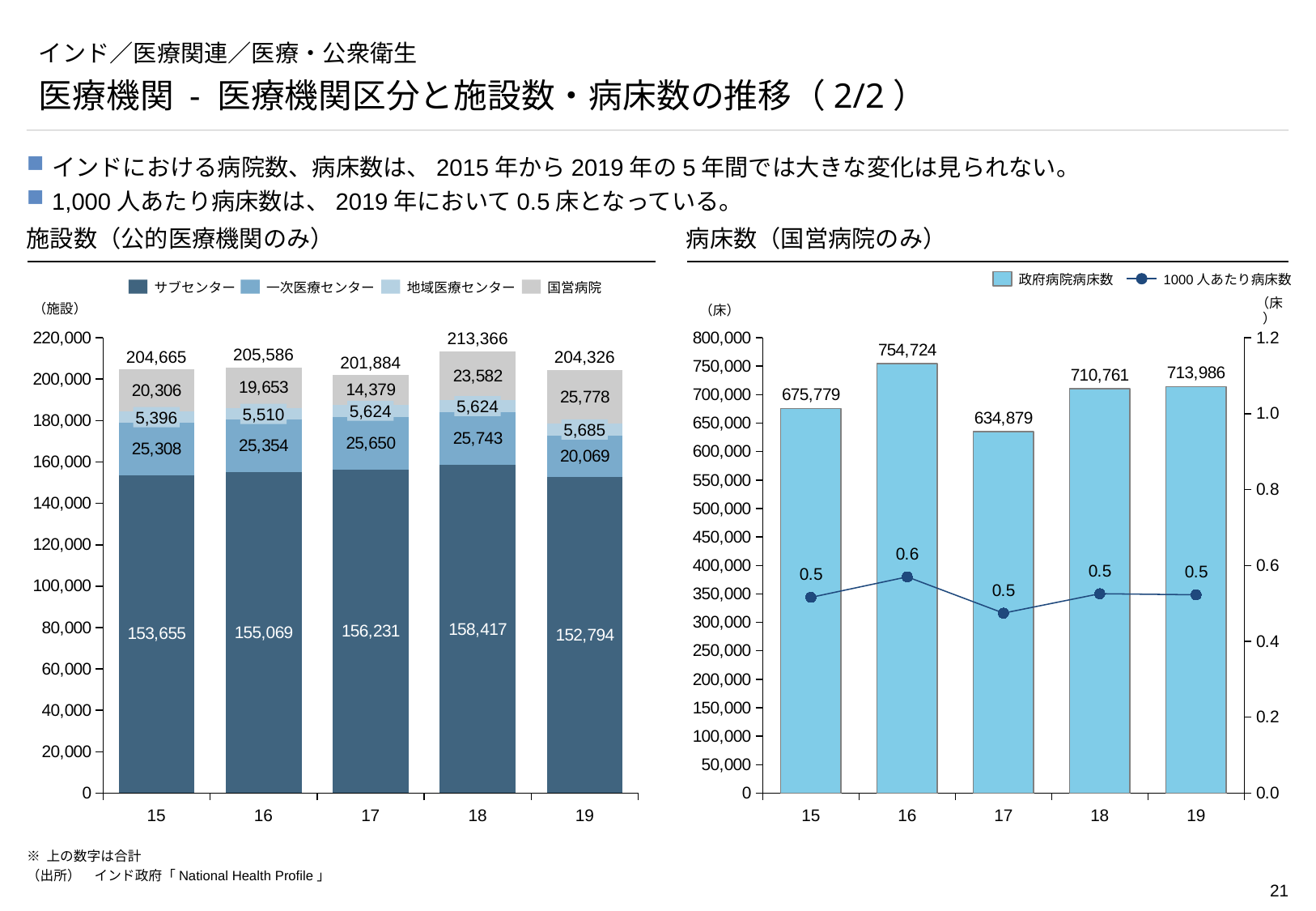
In the 施設数（公的医療機関のみ） chart, what is the total number of facilities shown above the bar for 18? 213,366 In the 病床数（国営病院のみ） chart, which year has the lowest value for 政府病院病床数? 17 In the 病床数（国営病院のみ） chart, what is the value for 1000人あたり病床数 in 16? 0.6 In the 病床数（国営病院のみ） chart, is the value for 政府病院病床数 in 15 greater or less than 700,000? less How many series does the legend of the 施設数（公的医療機関のみ） chart list? 4 In the 施設数（公的医療機関のみ） chart, what is the value for サブセンター in 19? 152,794 In the 施設数（公的医療機関のみ） chart, which year has the lowest value for サブセンター? 19 In the 施設数（公的医療機関のみ） chart, what is the difference between the 一次医療センター values for 18 and 19? 5,674 In the 施設数（公的医療機関のみ） chart, what is the value for 国営病院 in 17? 14,379 In the 病床数（国営病院のみ） chart, what is the value for 政府病院病床数 in 16? 754,724 What kind of chart is the 施設数（公的医療機関のみ） chart? Stacked bar chart In the 施設数（公的医療機関のみ） chart, which year has the highest total number of facilities? 18